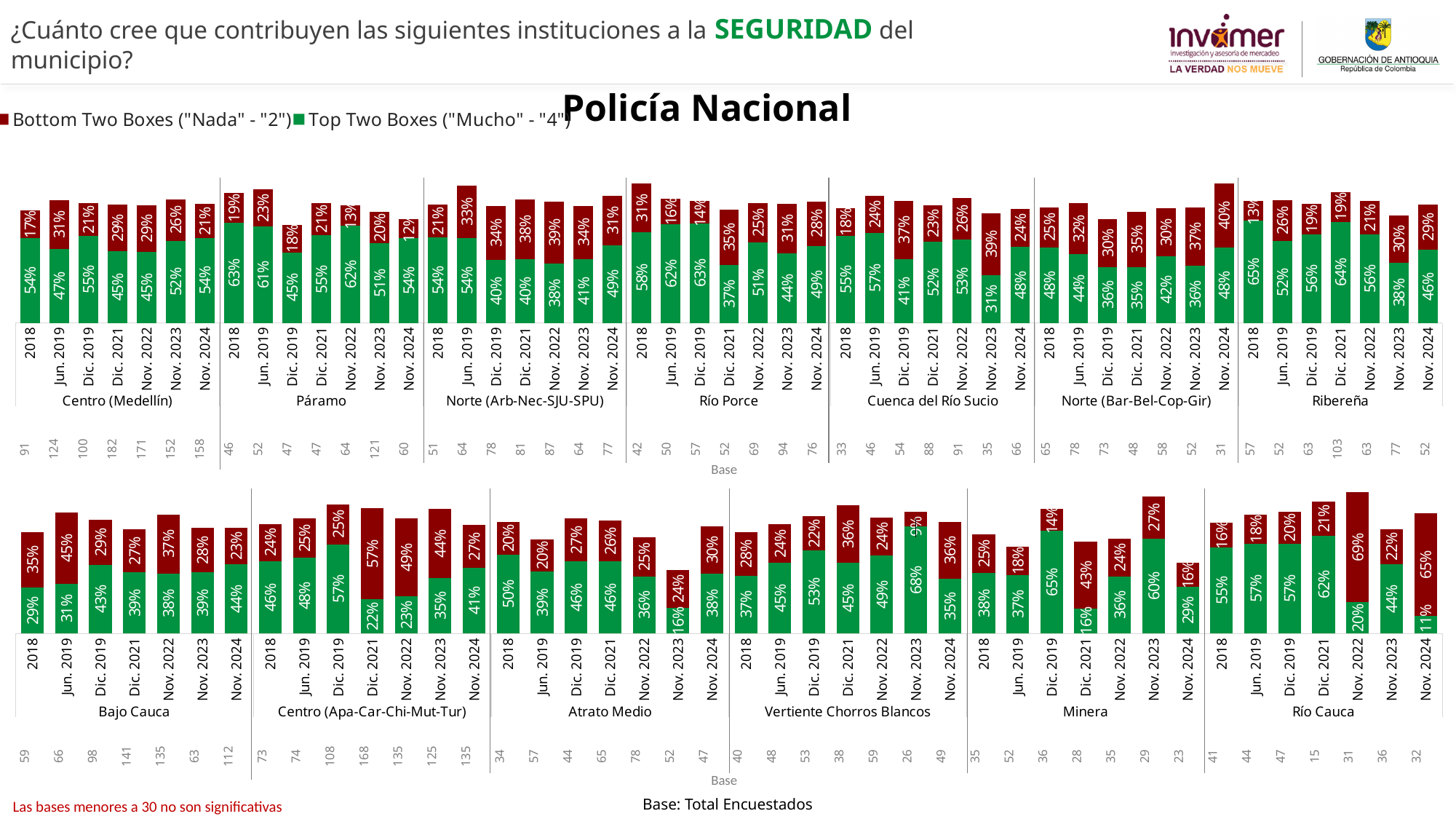
In the bottom chart, which is larger for Minera in Dic. 2019: the Top Two Boxes value or the Bottom Two Boxes value? Top Two Boxes How many series does the legend list? 2 In the bottom chart, which period has the lowest Top Two Boxes value for Río Cauca? Nov. 2024 In the bottom chart, what is the Top Two Boxes value for Vertiente Chorros Blancos in Nov. 2023? 68% How many periods are shown for each region in the top chart? 7 In the top chart, what is the Bottom Two Boxes value for Norte (Bar-Bel-Cop-Gir) in Nov. 2024? 40% In the top chart, what is the Top Two Boxes value for Centro (Medellín) in Nov. 2024? 54% In the top chart, which period has the highest Top Two Boxes value for Ribereña? 2018 In the bottom chart, what is the Bottom Two Boxes value for Río Cauca in Nov. 2022? 69% In the top chart, what is the total of the stacked bar for Río Porce in 2018 (Top Two Boxes plus Bottom Two Boxes)? 89% What kind of chart is used on this slide? Stacked bar chart In the bottom chart, what is the difference between the Bottom Two Boxes and Top Two Boxes values for Centro (Apa-Car-Chi-Mut-Tur) in Dic. 2021? 35%